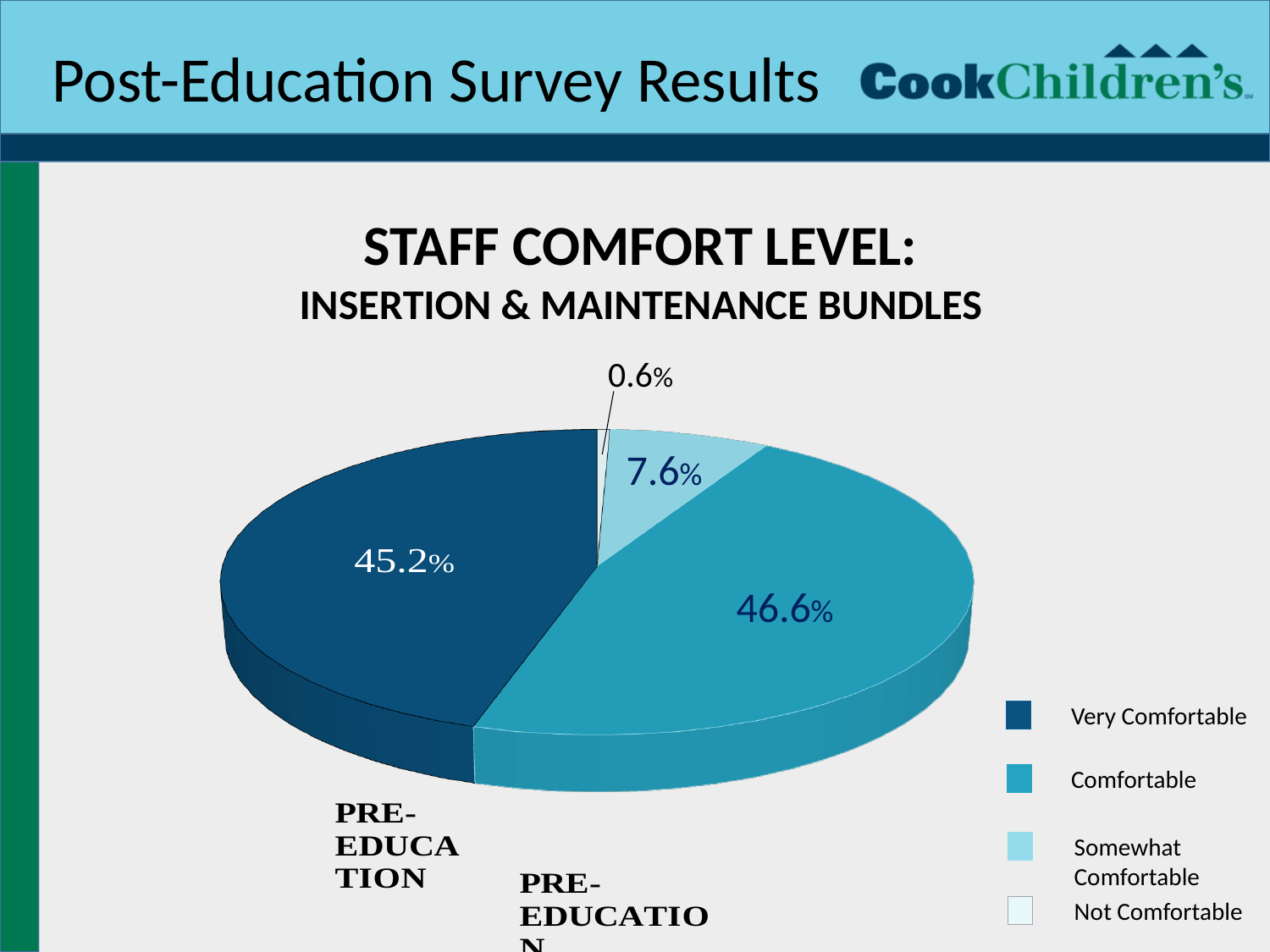
What is the difference between the Somewhat Comfortable and Not Comfortable percentages? 7.0% What kind of chart is shown on the slide? Pie chart Which comfort level has the largest share of the pie? Comfortable What percentage of staff reported being Somewhat Comfortable? 7.6% Which comfort level has the smallest share of the pie? Not Comfortable What percentage of staff reported being Not Comfortable? 0.6% What is the difference between the Comfortable and Very Comfortable percentages? 1.4% What percentage of staff reported being Comfortable? 46.6% Which is larger, the share for Very Comfortable or the share for Somewhat Comfortable? Very Comfortable What percentage of staff reported being Very Comfortable? 45.2% How many categories does the legend list? 4 What is the title of the chart? STAFF COMFORT LEVEL: INSERTION & MAINTENANCE BUNDLES